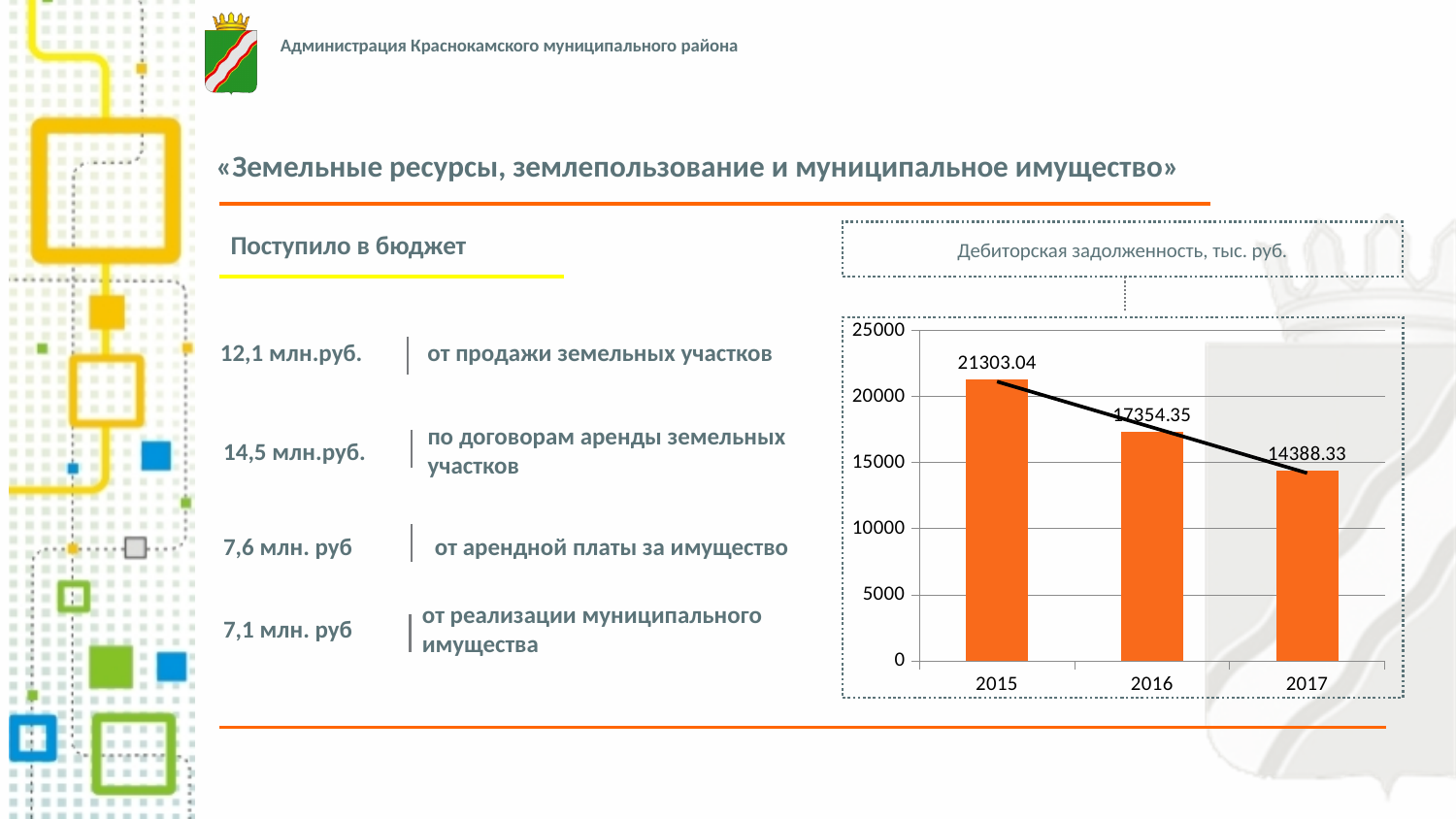
Is the value for 2016 in the chart 'Дебиторская задолженность, тыс. руб.' greater or less than 15000? greater Which year has the lowest value in the chart 'Дебиторская задолженность, тыс. руб.'? 2017 How many years are shown on the x axis of the chart 'Дебиторская задолженность, тыс. руб.'? 3 What is the value for 2016 in the chart 'Дебиторская задолженность, тыс. руб.'? 17354.35 What is the difference between the 2015 and 2017 values in the chart 'Дебиторская задолженность, тыс. руб.'? 6914.71 What is the value for 2015 in the chart 'Дебиторская задолженность, тыс. руб.'? 21303.04 What is the value for 2017 in the chart 'Дебиторская задолженность, тыс. руб.'? 14388.33 Which is larger in the chart 'Дебиторская задолженность, тыс. руб.': the value for 2016 or the value for 2017? 2016 Which year has the highest value in the chart 'Дебиторская задолженность, тыс. руб.'? 2015 What kind of chart is 'Дебиторская задолженность, тыс. руб.'? bar chart Do the values in the chart 'Дебиторская задолженность, тыс. руб.' rise or fall from 2015 to 2017? fall What is the difference between the 2015 and 2016 values in the chart 'Дебиторская задолженность, тыс. руб.'? 3948.69